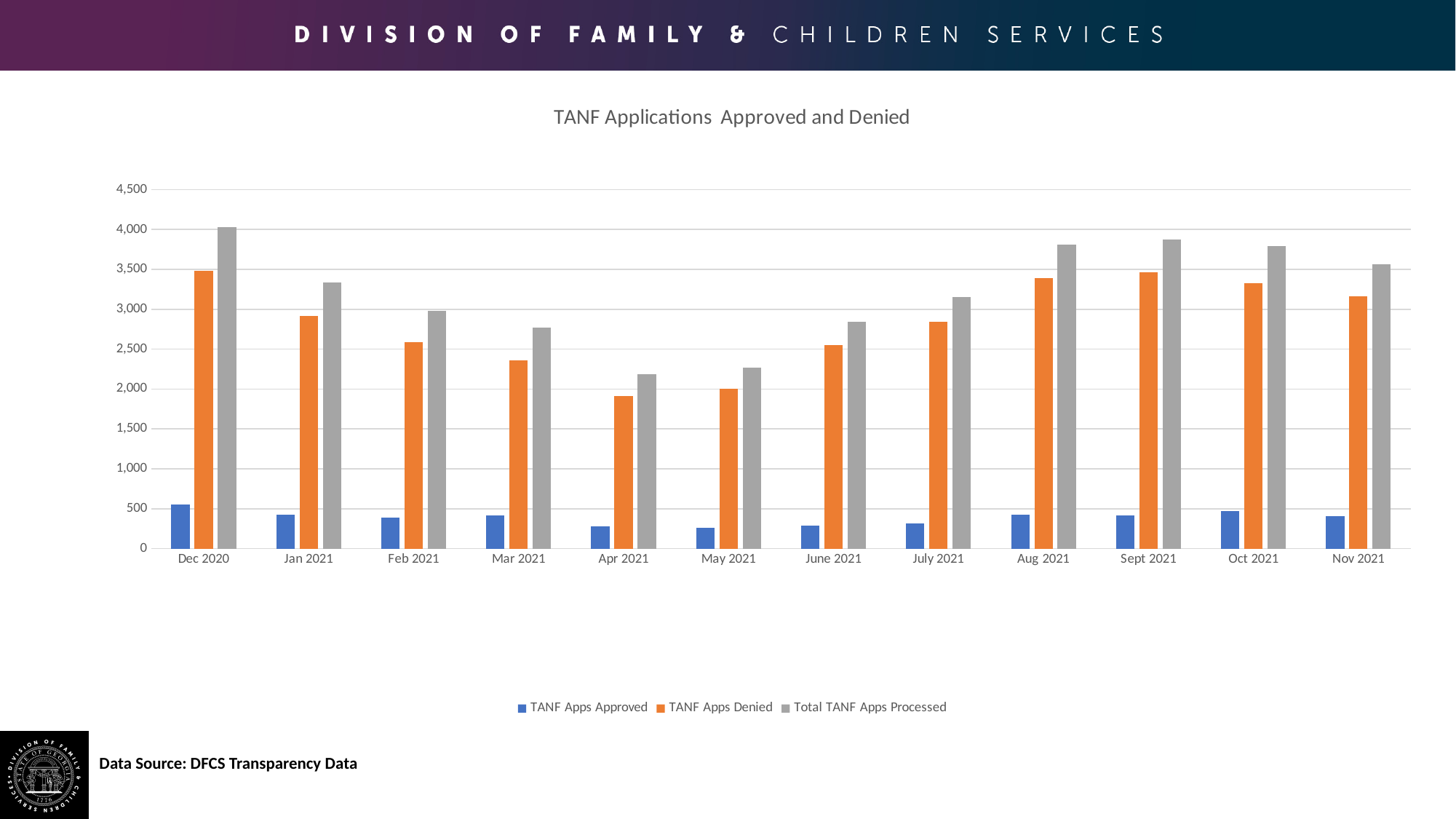
Is the value for Total TANF Apps Processed in Apr 2021 greater or less than 2,500? less Which month has the highest value for TANF Apps Approved? Dec 2020 Is the value for Total TANF Apps Processed in Sept 2021 greater or less than 3,500? greater Which month has the highest value for Total TANF Apps Processed? Dec 2020 Is the value for TANF Apps Approved in Apr 2021 greater or less than 500? less How many months are shown along the x axis? 12 What is the title of the chart? TANF Applications Approved and Denied Which is larger, TANF Apps Denied in Jan 2021 or in Feb 2021? Jan 2021 How many series does the legend list? 3 What kind of chart is shown on the slide? Bar chart Do the values for Total TANF Apps Processed rise or fall from Apr 2021 to Sept 2021? rise